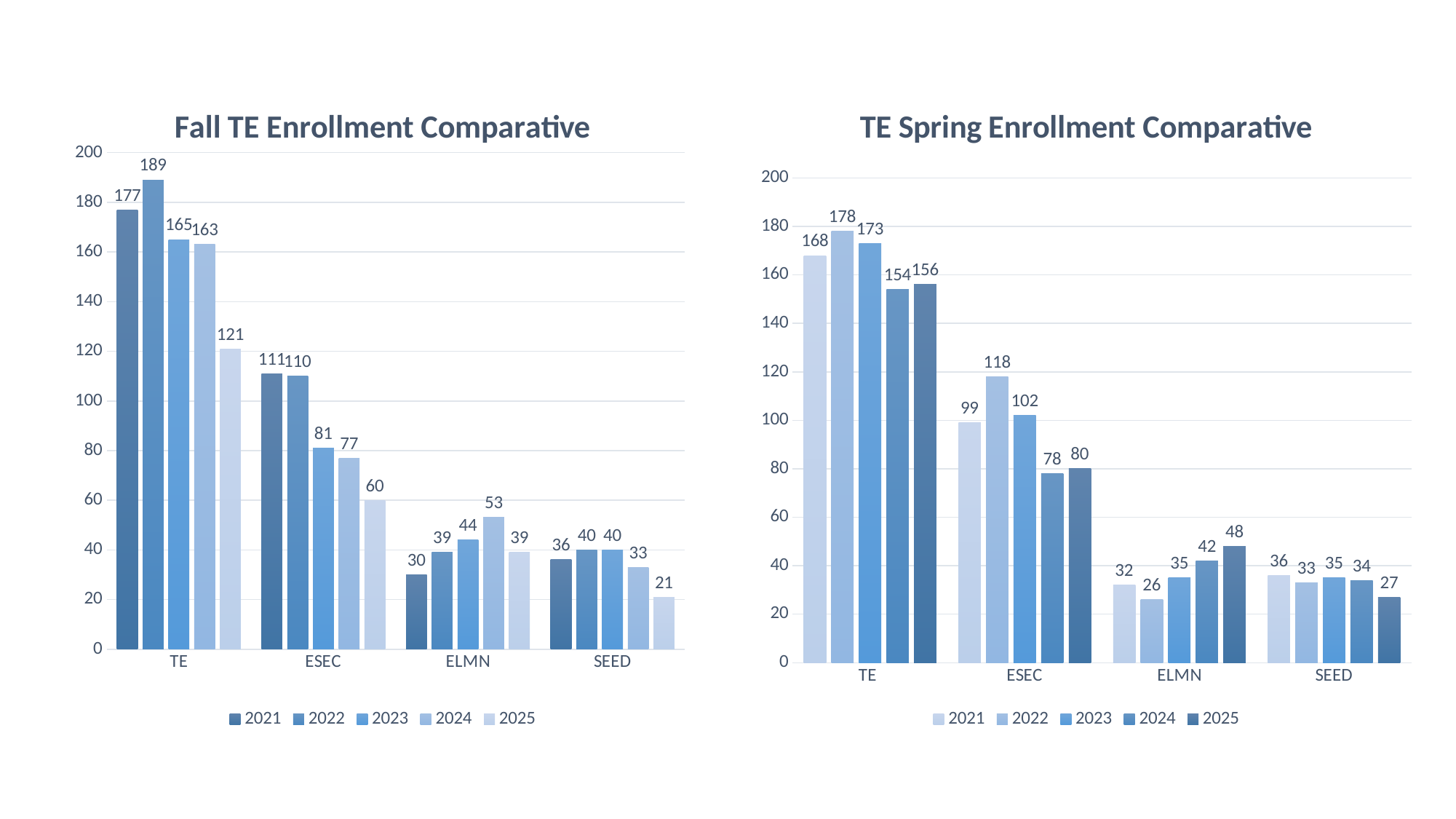
How many series does the legend of the TE Spring Enrollment Comparative chart list? 5 In the TE Spring Enrollment Comparative chart, is the value for ESEC in 2021 greater or less than 100? less In the TE Spring Enrollment Comparative chart, which year has the highest value for TE? 2022 In the TE Spring Enrollment Comparative chart, what is the difference between the ELMN values for 2025 and 2022? 22 In the Fall TE Enrollment Comparative chart, what is the difference between the TE values for 2021 and 2025? 56 In the Fall TE Enrollment Comparative chart, do the ESEC values rise or fall from 2021 to 2025? Fall What kind of chart is the Fall TE Enrollment Comparative chart? Bar chart In the Fall TE Enrollment Comparative chart, which year has the lowest value for SEED? 2025 In the TE Spring Enrollment Comparative chart, what is the value for ESEC in 2022? 118 How many categories are shown on the x axis of the Fall TE Enrollment Comparative chart? 4 In the Fall TE Enrollment Comparative chart, what is the value for TE in 2022? 189 In the Fall TE Enrollment Comparative chart, which is larger: ESEC in 2023 or ESEC in 2024? ESEC in 2023